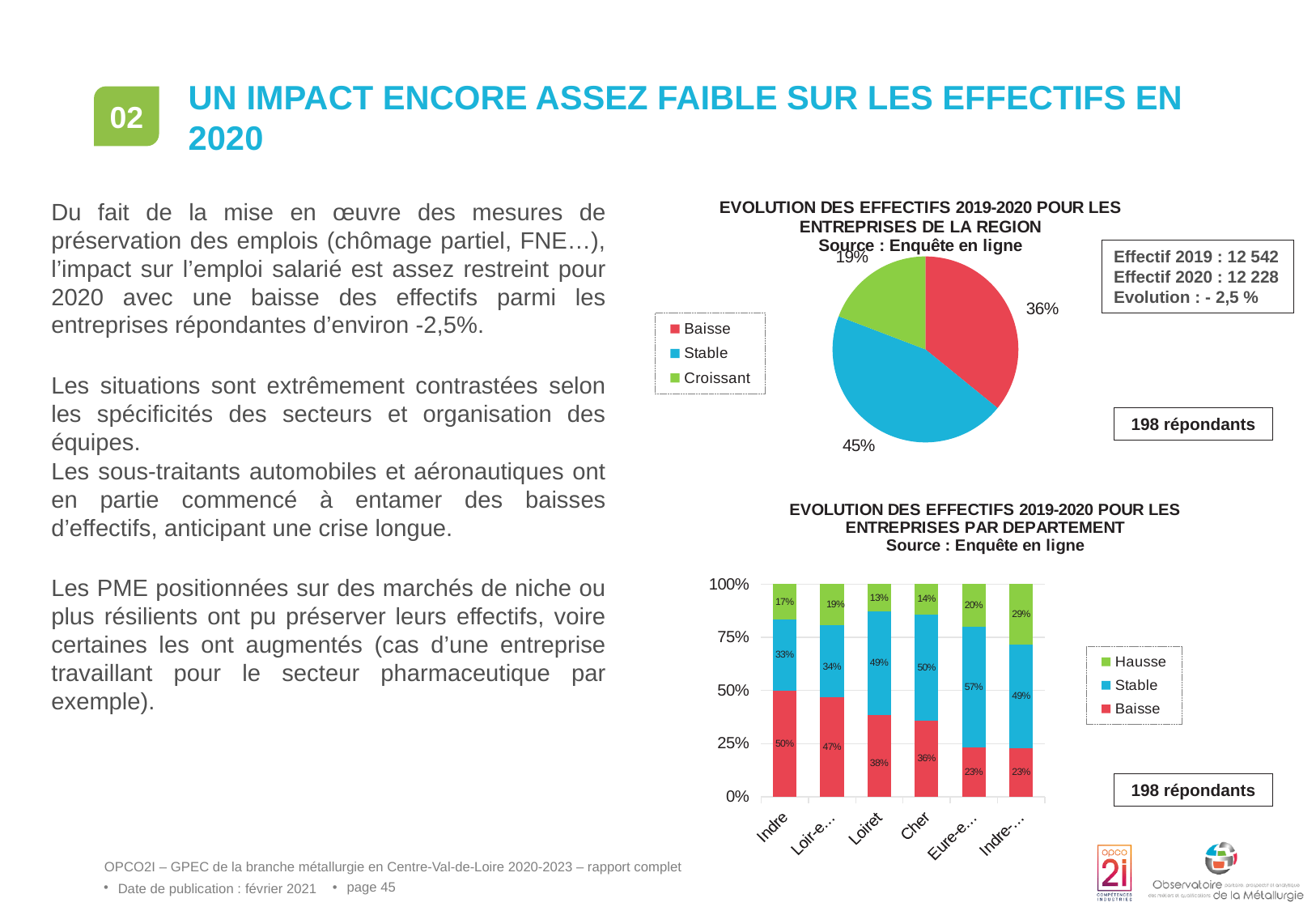
In the bar chart 'Evolution des effectifs 2019-2020 pour les entreprises par département', which has the larger 'Baisse' value, Indre or Loiret? Indre In the pie chart 'Evolution des effectifs 2019-2020 pour les entreprises de la région', which category has the largest slice? Stable How many entries does the legend of the pie chart 'Evolution des effectifs 2019-2020 pour les entreprises de la région' list? 3 What kind of chart is the top chart 'Evolution des effectifs 2019-2020 pour les entreprises de la région'? Pie chart In the bar chart 'Evolution des effectifs 2019-2020 pour les entreprises par département', what is the 'Stable' value for Cher? 50% In the bar chart 'Evolution des effectifs 2019-2020 pour les entreprises par département', what is the 'Baisse' value for Indre? 50% In the bar chart 'Evolution des effectifs 2019-2020 pour les entreprises par département', what is the 'Hausse' value for Loiret? 13% In the pie chart 'Evolution des effectifs 2019-2020 pour les entreprises de la région', which category has the smallest slice? Croissant How many departments (categories) are shown on the x axis of the bar chart 'Evolution des effectifs 2019-2020 pour les entreprises par département'? 6 In the pie chart 'Evolution des effectifs 2019-2020 pour les entreprises de la région', what share is labelled for 'Stable'? 45% In the pie chart 'Evolution des effectifs 2019-2020 pour les entreprises de la région', how many percentage points larger is 'Baisse' than 'Croissant'? 17 percentage points What kind of chart is the bottom chart 'Evolution des effectifs 2019-2020 pour les entreprises par département'? Stacked bar chart